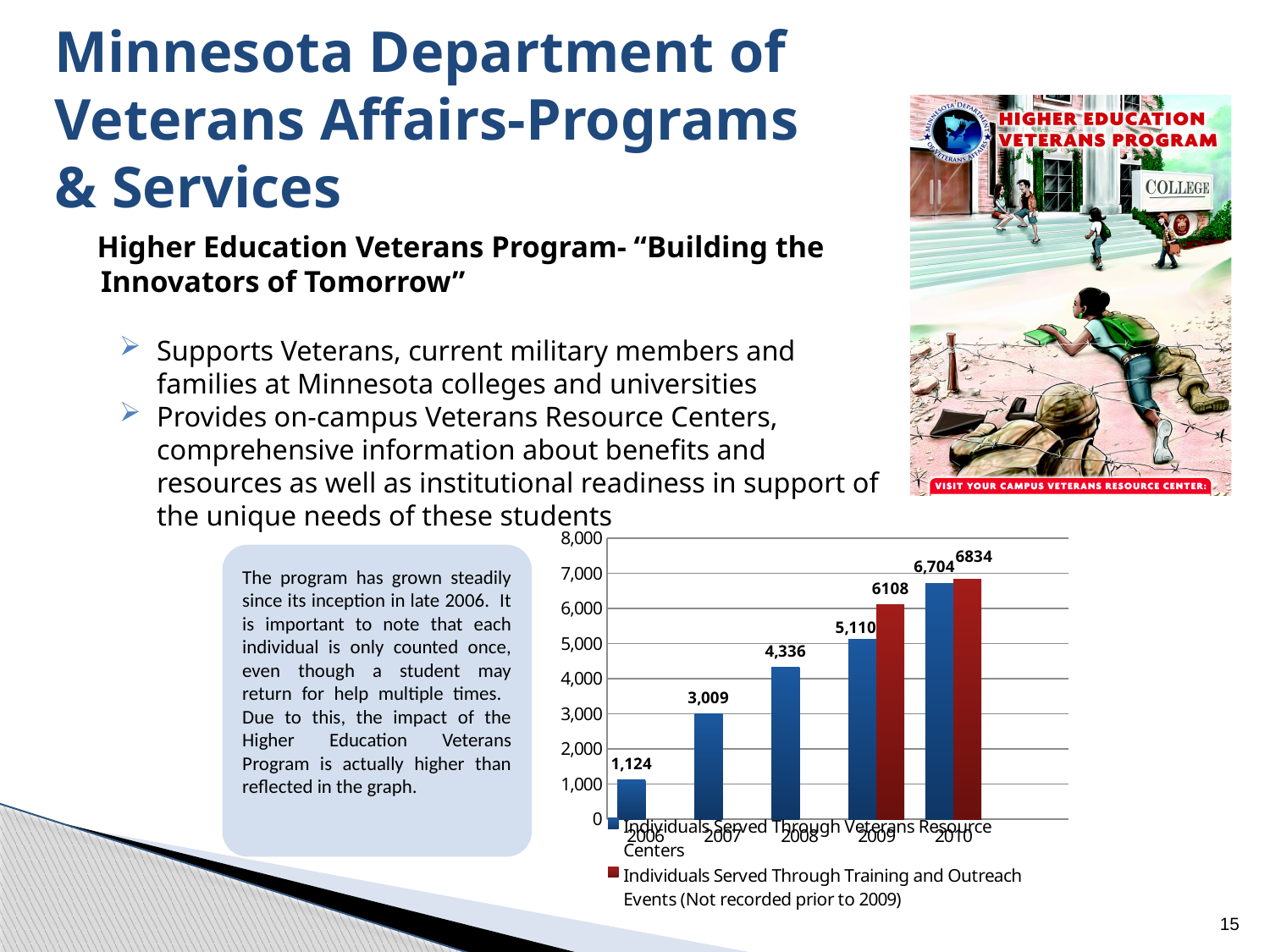
In which year was the number of individuals served through Veterans Resource Centers lowest? 2006 What kind of chart is shown on the slide? bar chart Does the number of individuals served through Veterans Resource Centers rise or fall from 2006 to 2010? rise How many individuals were served through Training and Outreach Events in 2009? 6108 How many years are shown on the x axis of the chart? 5 How many series does the chart legend list? 2 How many individuals were served through Training and Outreach Events in 2010? 6834 How many individuals were served through Veterans Resource Centers in 2006? 1,124 In 2009, which was larger: individuals served through Veterans Resource Centers or through Training and Outreach Events? Training and Outreach Events How many individuals were served through Veterans Resource Centers in 2008? 4,336 In which year was the number of individuals served through Veterans Resource Centers highest? 2010 What is the difference between the number of individuals served through Veterans Resource Centers in 2010 and in 2009? 1,594